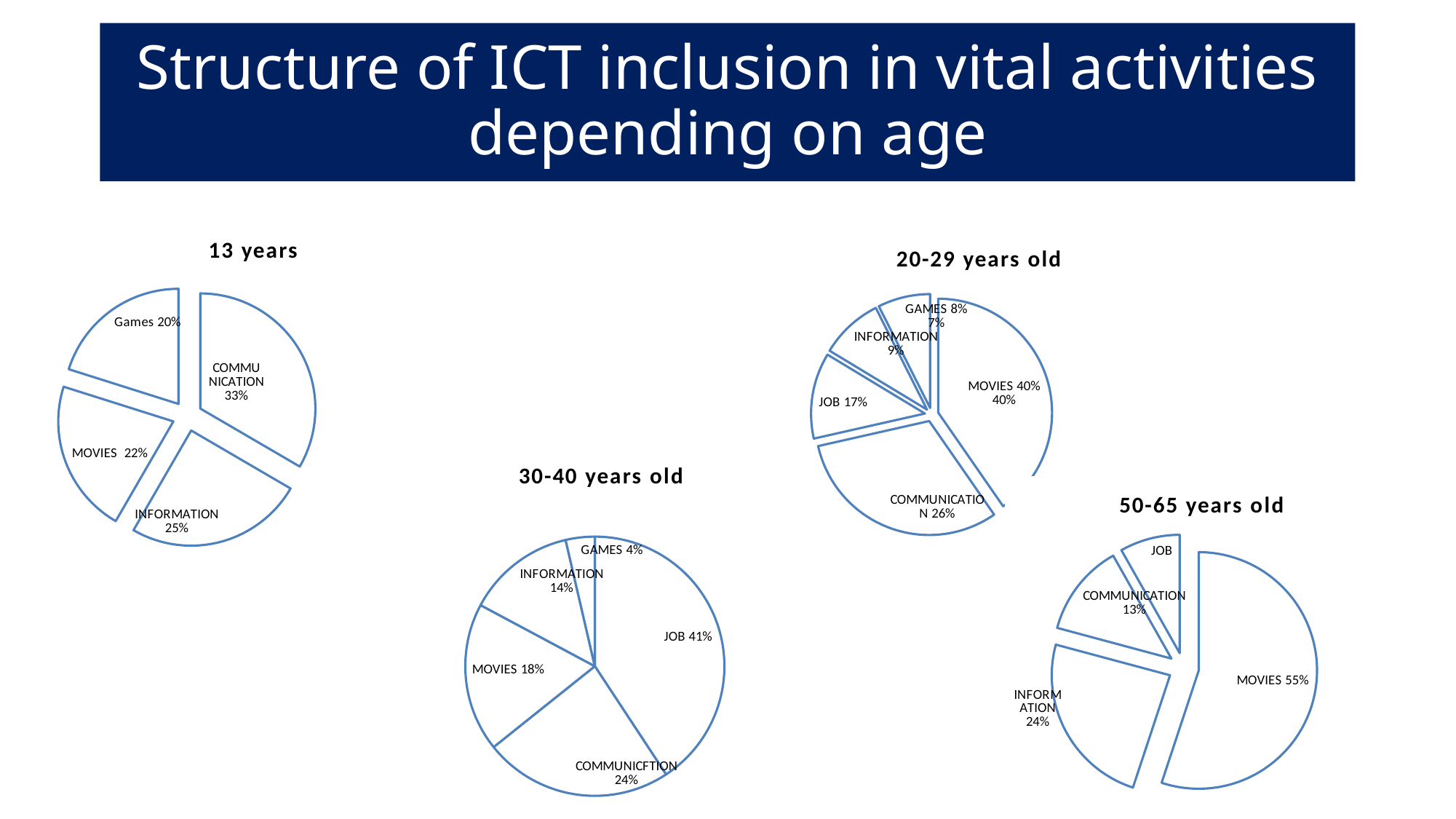
In the '13 years' pie chart, what percentage is shown for COMMUNICATION? 33% In the '13 years' pie chart, which category has the largest share? COMMUNICATION In the '13 years' pie chart, how many slices are there? 4 In the '30-40 years old' pie chart, what percentage is shown for JOB? 41% In the '50-65 years old' pie chart, which is larger, INFORMATION or COMMUNICATION? INFORMATION In the '20-29 years old' pie chart, what percentage is shown for MOVIES? 40% In the '30-40 years old' pie chart, what is the difference in percentage points between JOB and COMMUNICATION? 17 percentage points In the '20-29 years old' pie chart, what percentage is shown for JOB? 17% In the '13 years' pie chart, which category has the smallest share? Games In the '50-65 years old' pie chart, what percentage is shown for MOVIES? 55% What type of chart is used on this slide? Pie chart In the '30-40 years old' pie chart, which category has the smallest share? GAMES